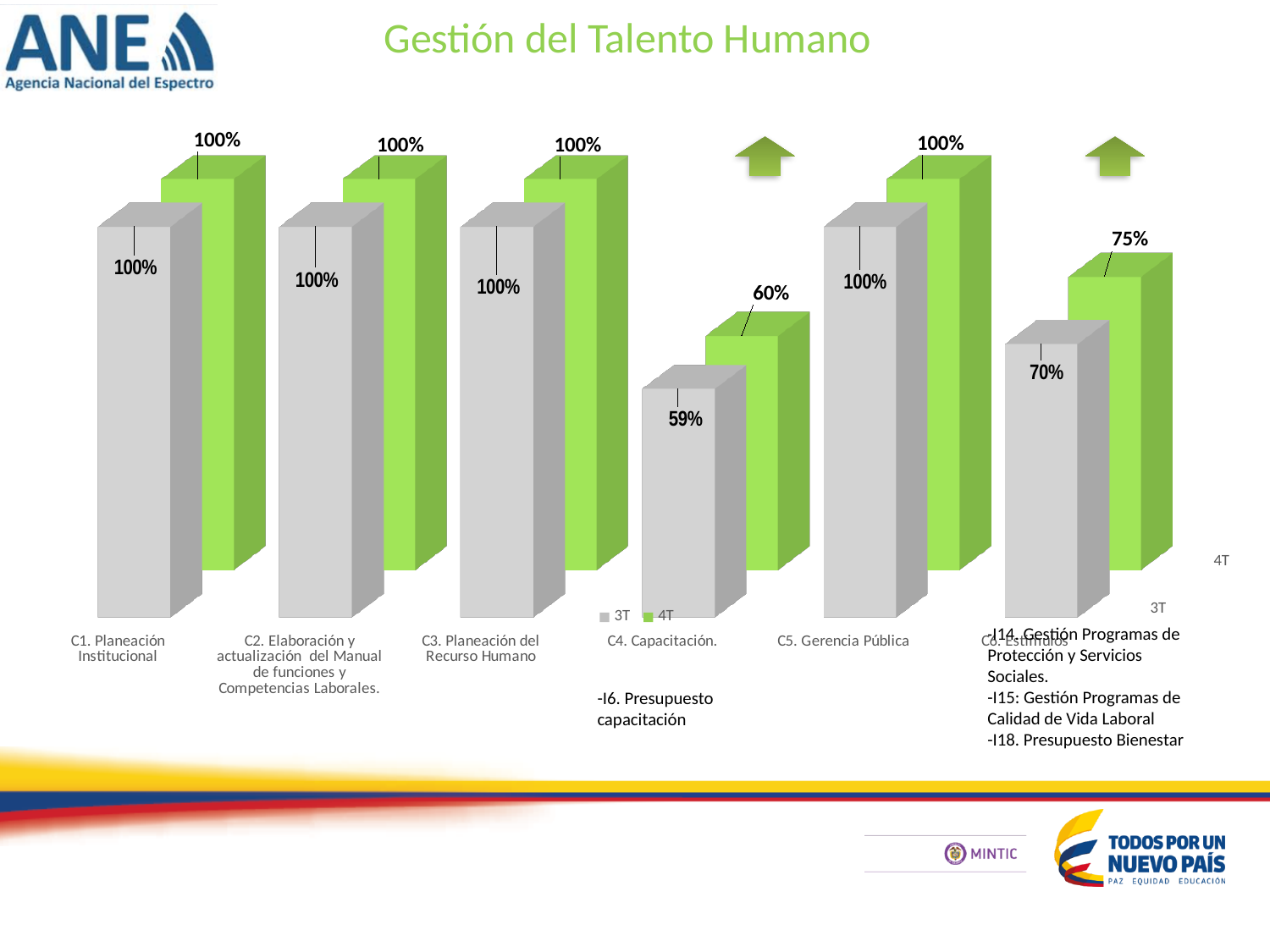
What is the 4T value for C4. Capacitación? 60% What is the 4T value for C5. Gerencia Pública? 100% Which category has the lowest 3T value? C4. Capacitación Which is larger, the 4T value for C6. Estímulos or the 4T value for C4. Capacitación? C6. Estímulos What is the 3T value for C6. Estímulos? 70% What is the 3T value for C4. Capacitación? 59% What kind of chart is shown on the slide? Bar chart What is the difference between the 4T and 3T values for C6. Estímulos? 5% What is the 4T value for C6. Estímulos? 75% How many series does the legend list? 2 What is the difference between the 4T value for C1. Planeación Institucional and the 4T value for C4. Capacitación? 40% Which series is shown in green? 4T